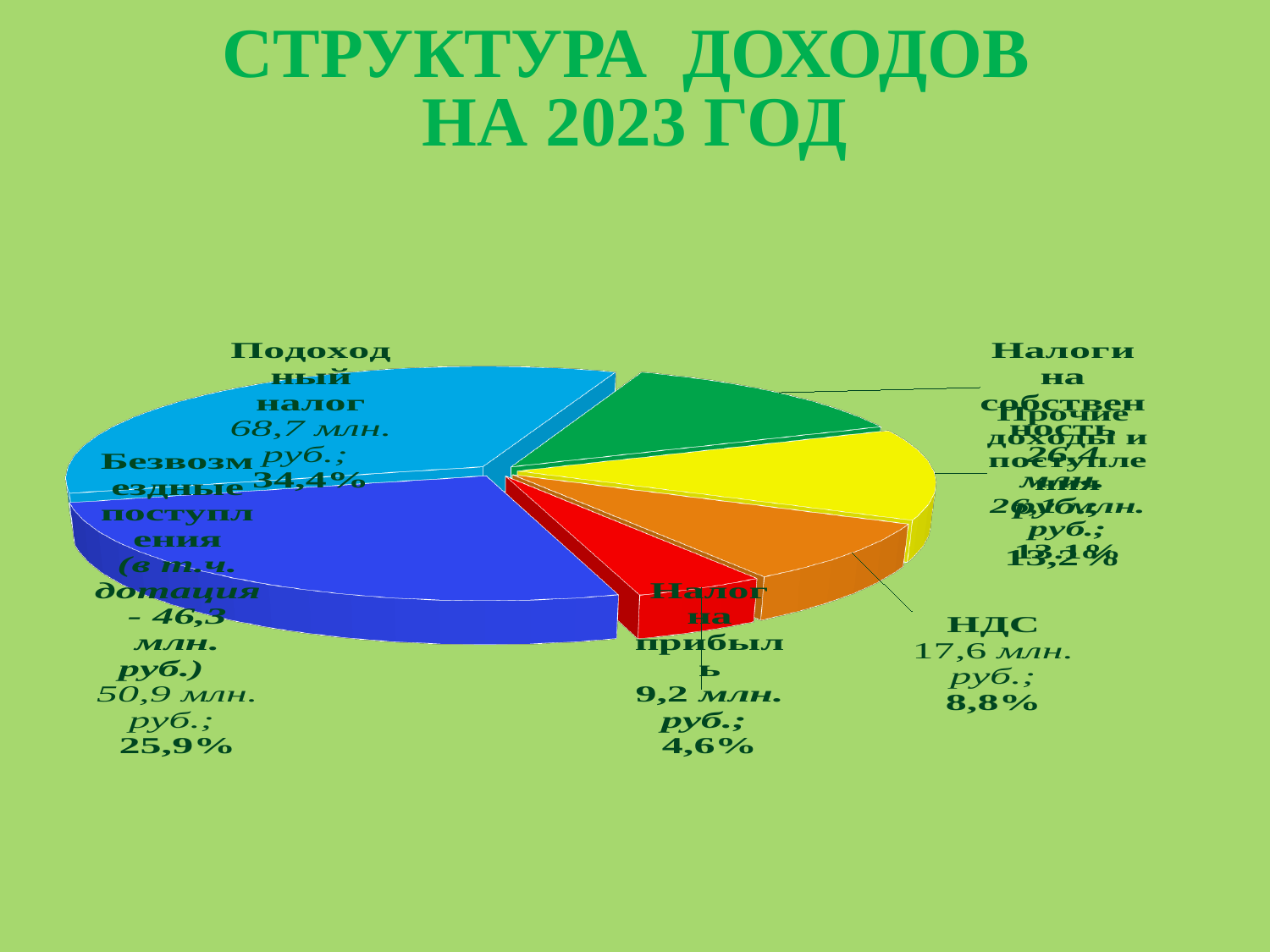
What share of the pie does Подоходный налог have? 34,4% What is the difference between the values for Подоходный налог and Безвозмездные поступления? 17,8 млн. руб. What is the value shown for НДС? 17,6 млн. руб. What is the value shown for Налог на прибыль? 9,2 млн. руб. Which is larger, НДС or Налог на прибыль? НДС What is the value shown for Подоходный налог? 68,7 млн. руб. What share of the pie do Безвозмездные поступления have? 25,9% What is the title of the chart on the slide? СТРУКТУРА ДОХОДОВ НА 2023 ГОД Which category has the smallest slice of the pie? Налог на прибыль Which category has the largest slice of the pie? Подоходный налог What kind of chart is shown on the slide? pie chart What share of the pie does НДС have? 8,8%